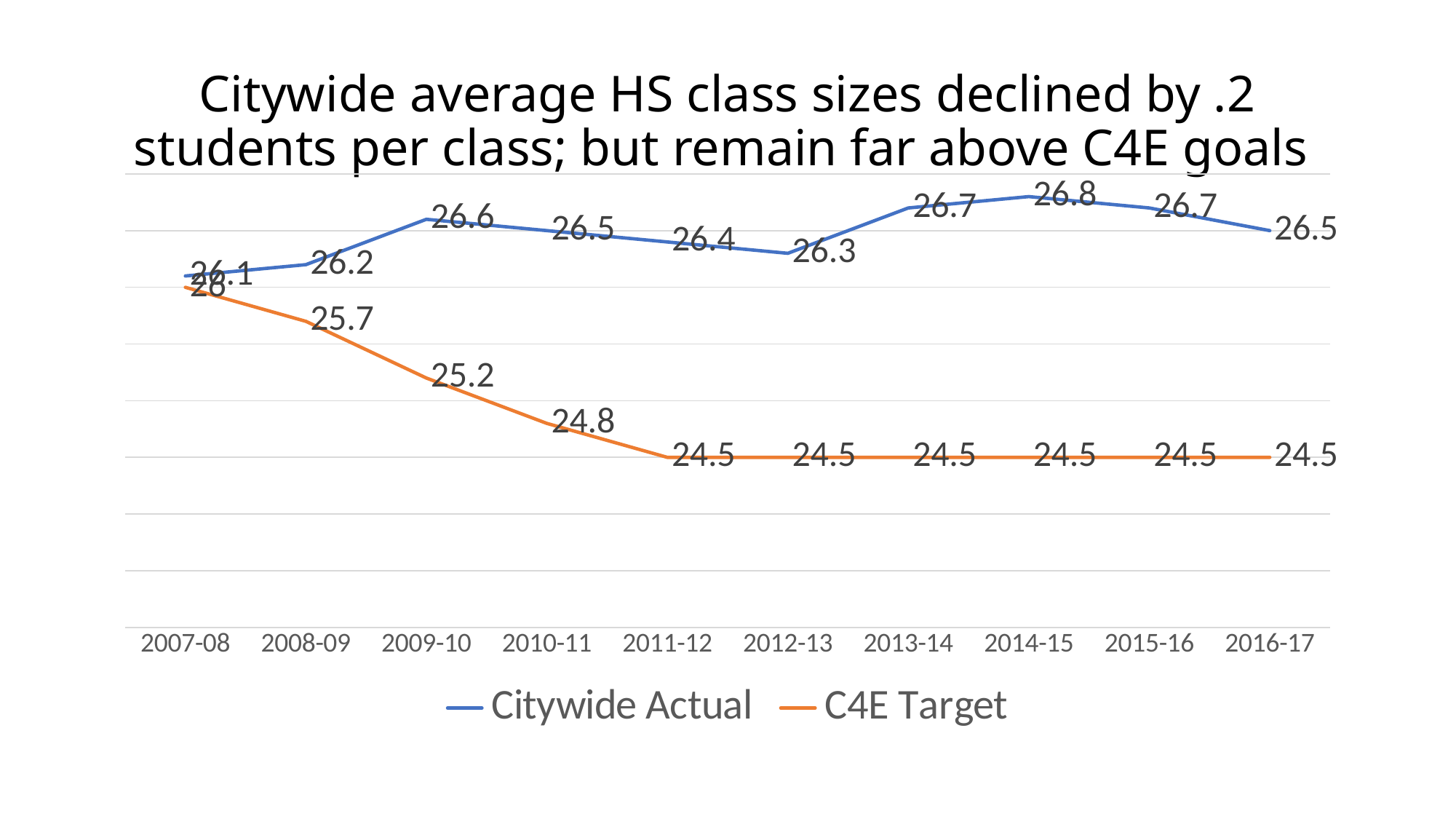
What is the Citywide Actual value for 2016-17? 26.5 How many school years are shown on the x axis? 10 What is the Citywide Actual value for 2014-15? 26.8 In which school year is the Citywide Actual value highest? 2014-15 Which series has the larger value in 2011-12, Citywide Actual or C4E Target? Citywide Actual What is the C4E Target value for 2009-10? 25.2 What kind of chart is shown on the slide? line chart In which school year is the Citywide Actual value lowest? 2007-08 Which colour is used for the C4E Target line? orange What is the difference between the Citywide Actual and C4E Target values in 2016-17? 2 How many series does the legend list? 2 Does the C4E Target series rise or fall from 2007-08 to 2011-12? fall